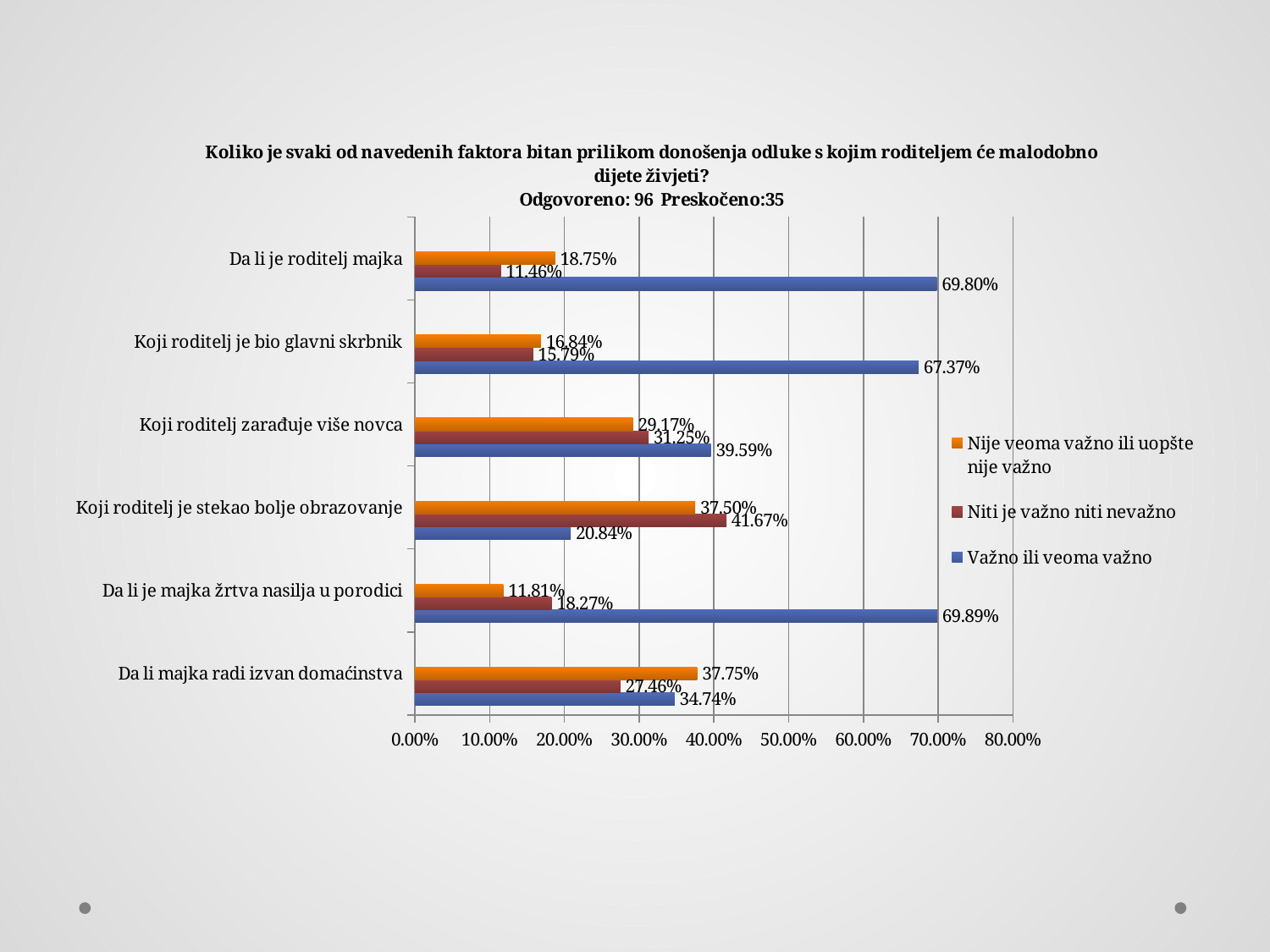
How many series does the legend list? 3 How many categories are shown on the chart? 6 Which category has the lowest value for "Nije veoma važno ili uopšte nije važno"? Da li je majka žrtva nasilja u porodici For "Koji roditelj zarađuje više novca", which is larger: "Važno ili veoma važno" or "Niti je važno niti nevažno"? Važno ili veoma važno What is the value of "Nije veoma važno ili uopšte nije važno" for "Da li majka radi izvan domaćinstva"? 37.75% What is the value of "Niti je važno niti nevažno" for "Koji roditelj je stekao bolje obrazovanje"? 41.67% What is the value of "Važno ili veoma važno" for "Da li je roditelj majka"? 69.80% What is the difference between "Važno ili veoma važno" and "Nije veoma važno ili uopšte nije važno" for "Da li je roditelj majka"? 51.05% Is the value of "Važno ili veoma važno" for "Koji roditelj je bio glavni skrbnik" greater or less than 60.00%? greater Which category has the lowest value for "Važno ili veoma važno"? Koji roditelj je stekao bolje obrazovanje Which category has the highest value for "Niti je važno niti nevažno"? Koji roditelj je stekao bolje obrazovanje What kind of chart is shown on the slide? Bar chart